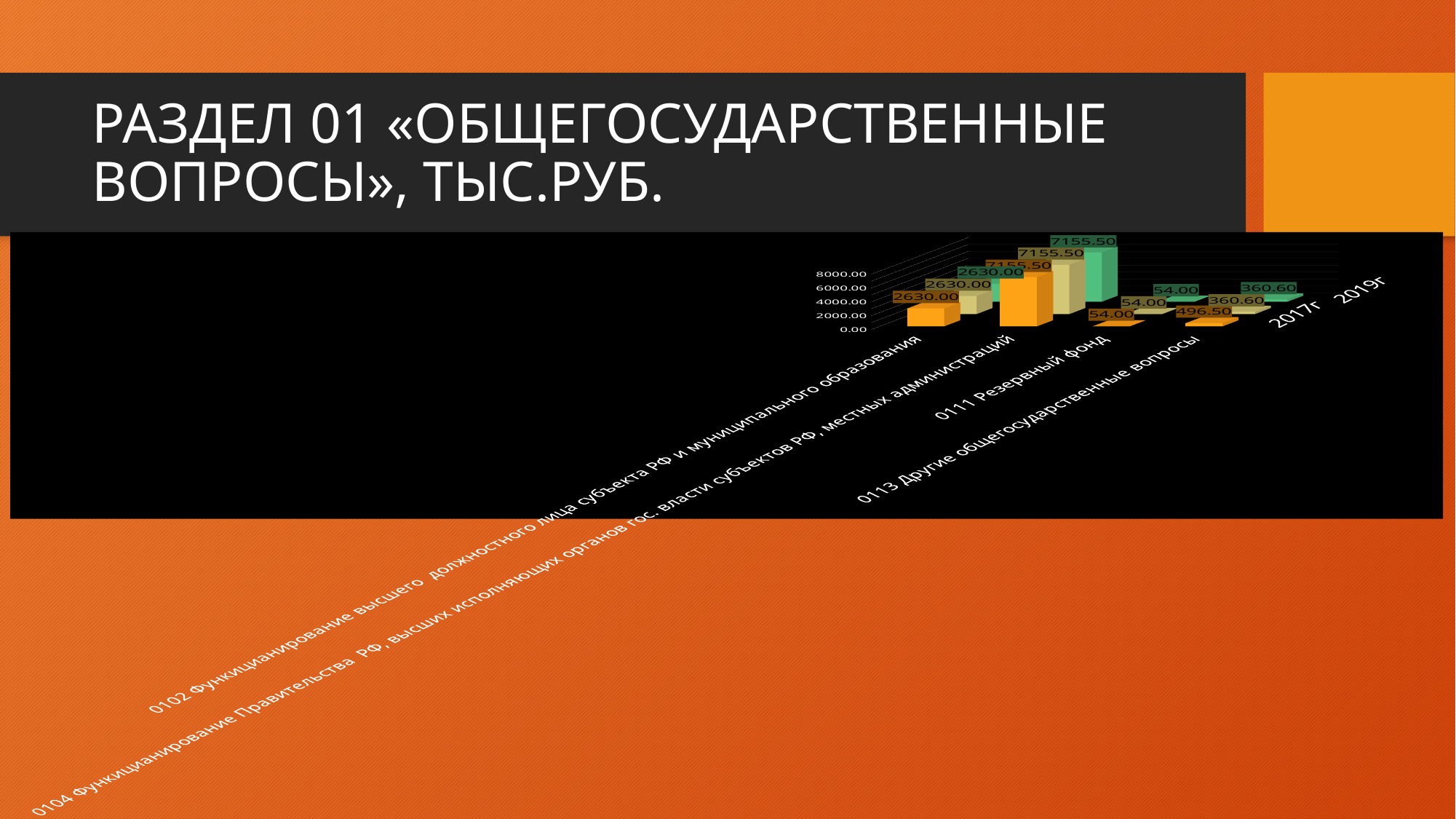
Which category has the lowest values on the chart? 0111 Резервный фонд What is the 2017г value for category 0102 Функционирование высшего должностного лица субъекта РФ и муниципального образования? 2630.00 Which category has the highest values on the chart? 0104 Функционирование Правительства РФ, высших исполняющих органов гос. власти субъектов РФ, местных администраций What is the difference between the 2017г and 2019г values for category 0113 Другие общегосударственные вопросы? 135.90 What is the 2019г value for category 0104 Функционирование Правительства РФ, высших исполняющих органов гос. власти субъектов РФ, местных администраций? 7155.50 What is the 2017г value for category 0111 Резервный фонд? 54.00 Which is larger for 2019г: the value for 0102 or the value for 0104? 0104 How many categories are shown on the chart? 4 What is the highest tick value shown on the vertical axis? 8000.00 What is the 2017г value for category 0113 Другие общегосударственные вопросы? 496.50 What kind of chart is shown on the slide? bar chart What is the 2019г value for category 0113 Другие общегосударственные вопросы? 360.60